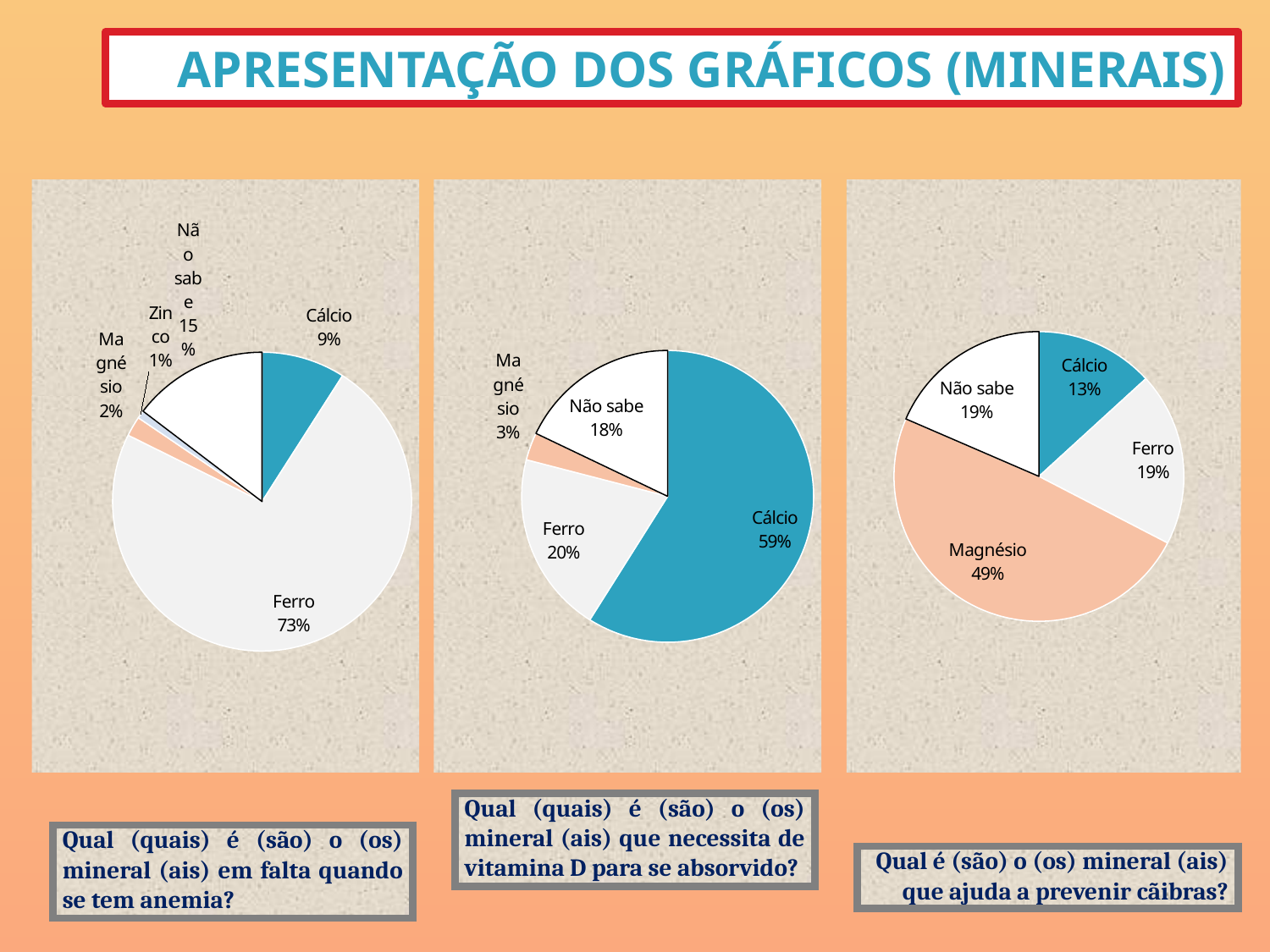
What type of chart is the middle chart? Pie chart In the right pie chart, which category has the smallest slice? Cálcio In the left pie chart, which category has the smallest slice? Zinco In the middle pie chart, which is larger, Cálcio or Ferro? Cálcio In the middle pie chart, what is the difference between the Ferro and Não sabe shares? 2% In the middle pie chart, what share does Cálcio have? 59% In the middle pie chart, which category has the smallest slice? Magnésio In the left pie chart, what share does Ferro have? 73% In the left pie chart, how many slices are there? 5 In the left pie chart, which category has the largest slice? Ferro In the right pie chart, how many slices are there? 4 In the right pie chart, what share does Magnésio have? 49%